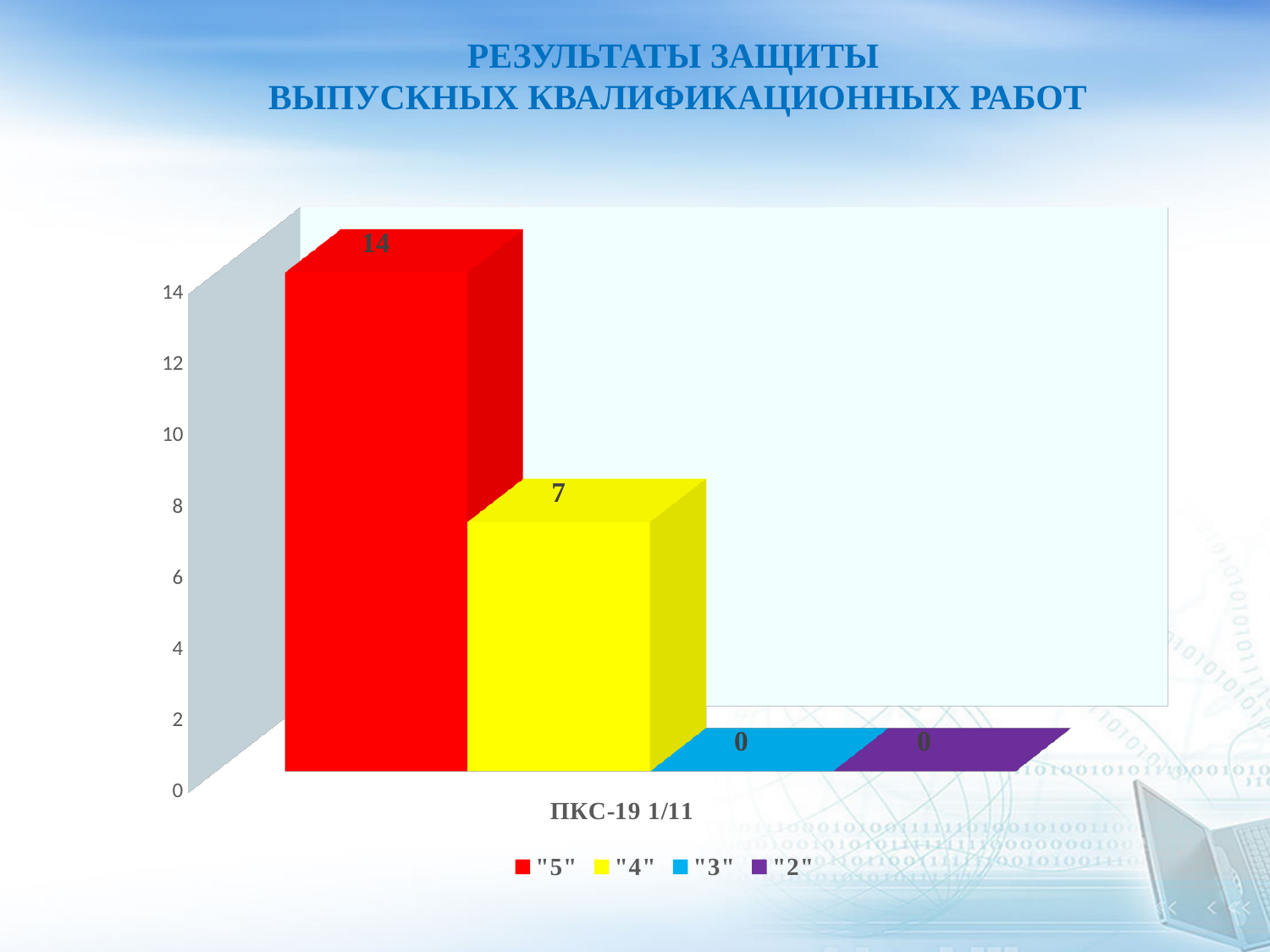
Which is larger, the value for "5" or the value for "4"? "5" What is the value for the "2" series for ПКС-19 1/11? 0 What is the value for the "3" series for ПКС-19 1/11? 0 Which series has the highest value? "5" What kind of chart is shown on the slide? bar chart How many series does the legend list? 4 What is the category label on the x axis? ПКС-19 1/11 How many categories are shown on the x axis? 1 What colour is the bar for the "4" series? yellow What is the value for the "4" series for ПКС-19 1/11? 7 What is the difference between the "5" and "4" values? 7 What is the value for the "5" series for ПКС-19 1/11? 14